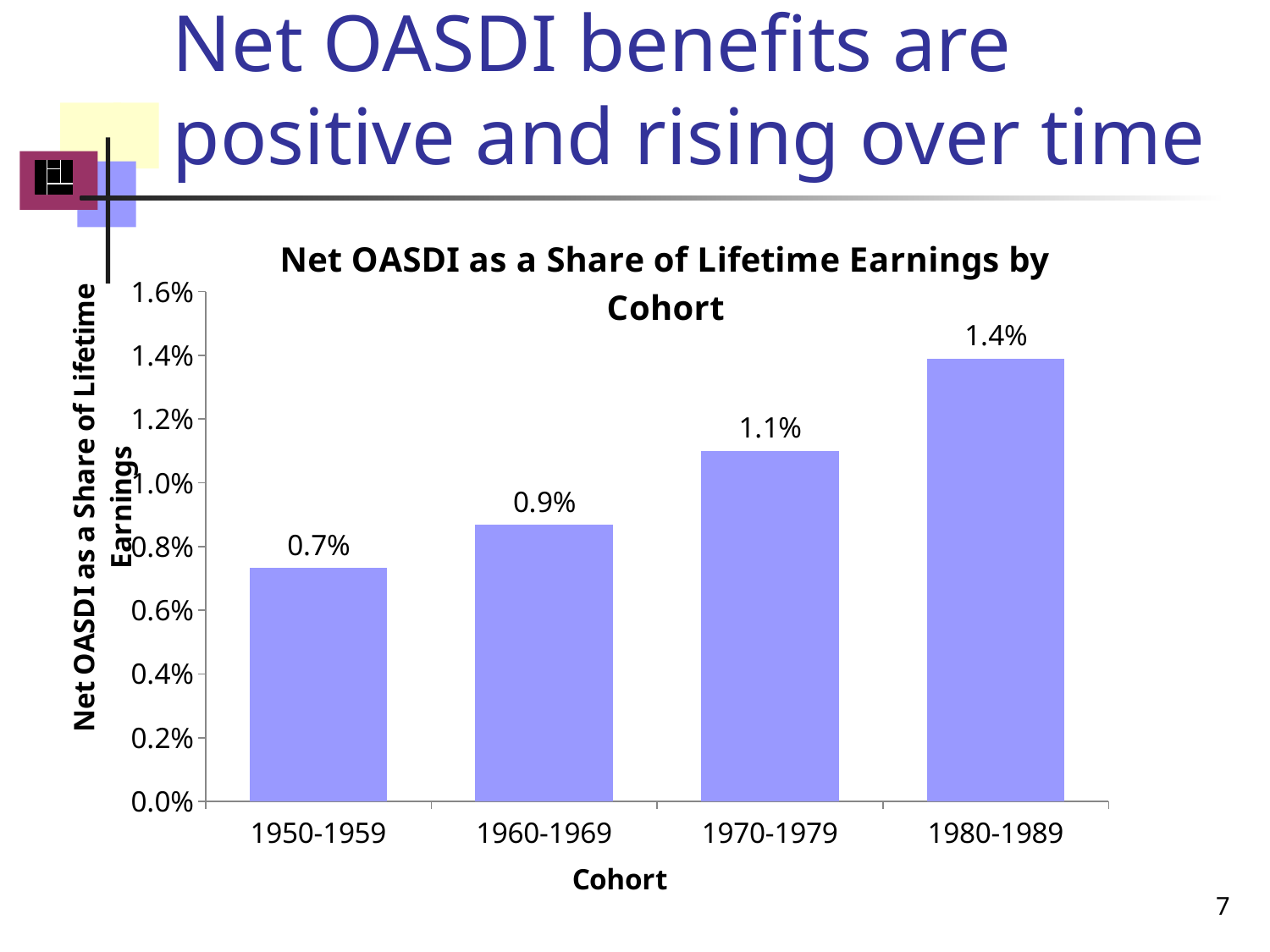
Is the value for the 1980-1989 cohort greater or less than 1.2%? greater What is the value for the 1980-1989 cohort? 1.4% How many cohorts are shown on the chart? 4 What is the value for the 1950-1959 cohort? 0.7% What is the difference between the values for the 1980-1989 and 1950-1959 cohorts, using the printed labels? 0.7% What is the value for the 1970-1979 cohort? 1.1% Which cohort has the lowest net OASDI as a share of lifetime earnings? 1950-1959 What kind of chart is shown on the slide? bar chart What is the value for the 1960-1969 cohort? 0.9% Which cohort has the highest net OASDI as a share of lifetime earnings? 1980-1989 Do the values rise or fall from the 1950-1959 cohort to the 1980-1989 cohort? rise Which is larger, the value for 1960-1969 or the value for 1970-1979? 1970-1979